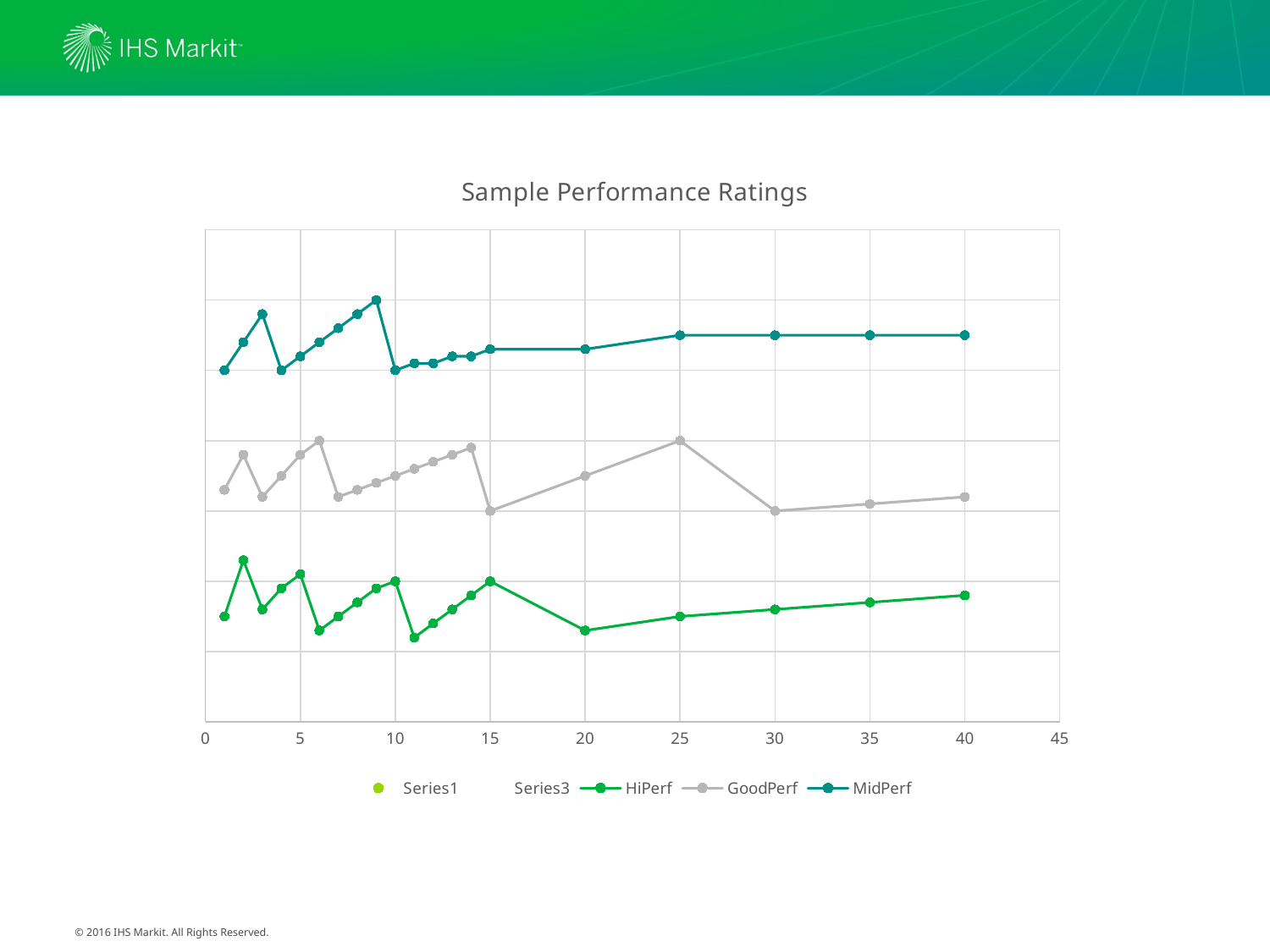
Does the MidPerf line rise or fall between x = 1 and x = 2? Rises How many series does the legend list? 5 At what x value does the last data point of each line appear? 40 Does the GoodPerf line rise or fall between x = 25 and x = 30? Falls What is the largest value shown on the x axis? 45 What is the title of the chart? Sample Performance Ratings Does the HiPerf line rise or fall between x = 20 and x = 40? Rises Which series is plotted lowest on the chart? HiPerf For the MidPerf line, which is higher, the point at x = 9 or the point at x = 10? x = 9 At x = 25, which is higher, the GoodPerf line or the HiPerf line? GoodPerf What kind of chart is shown on the slide? Line chart